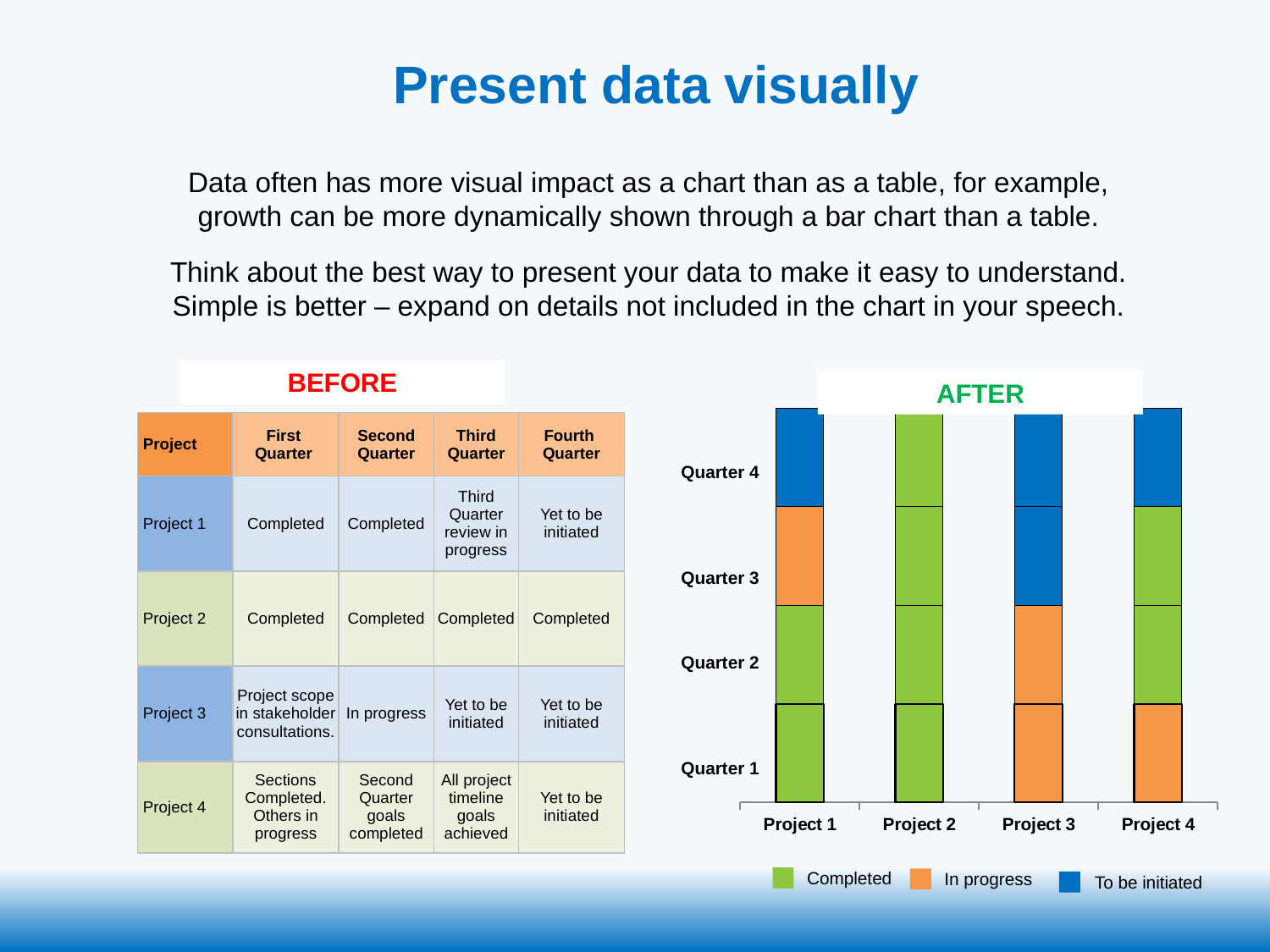
In the AFTER chart, what is the status of Project 4 in Quarter 4? To be initiated In the AFTER chart, how many quarters are shown for each project? 4 What kind of chart is shown under the AFTER heading? Stacked bar chart In the AFTER chart, what is the status of Project 2 in Quarter 4? Completed In the AFTER chart, what is the status of Project 1 in Quarter 3? In progress How many projects are shown on the x axis of the AFTER chart? 4 In the AFTER chart, which project has all four quarters marked as Completed? Project 2 In the AFTER chart, which colour represents 'Completed'? Green In the AFTER chart, which colour represents 'To be initiated'? Blue In the AFTER chart, what is the status of Project 3 in Quarter 1? In progress How many series does the legend of the AFTER chart list? 3 In the AFTER chart, which project has the most quarters marked 'To be initiated'? Project 3